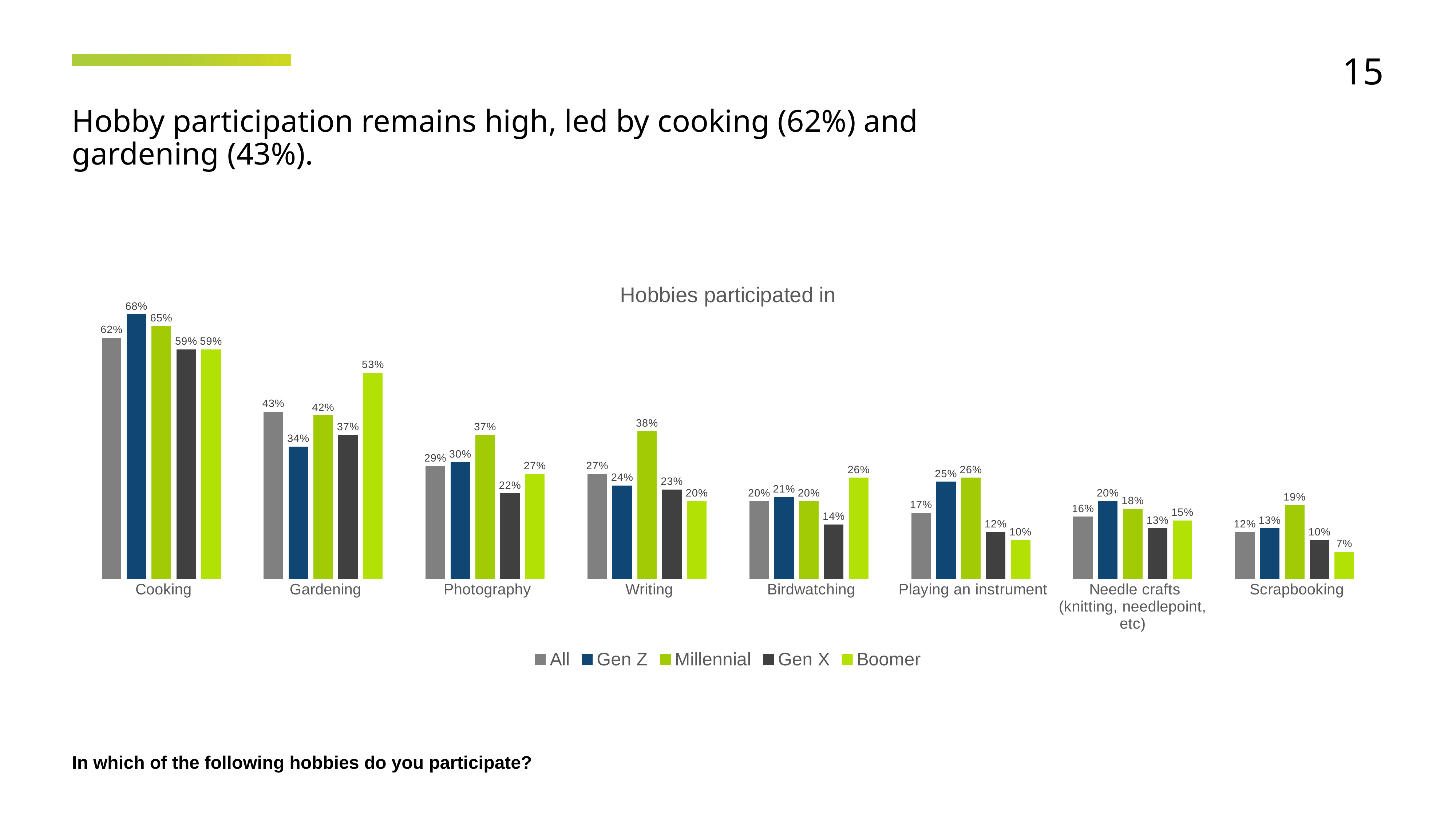
What is the title of the chart? Hobbies participated in Which is larger for Birdwatching: the Boomer value or the Gen X value? Boomer What kind of chart is shown on the slide? Bar chart What is the value for Boomer in the Gardening category? 53% Which hobby has the highest value for the All series? Cooking What is the difference between the Gen Z and Gen X values for Gardening? 3% What is the value for Gen Z in the Cooking category? 68% What is the value for Gen X in the Scrapbooking category? 10% How many series does the legend list? 5 What is the value for Millennial in the Writing category? 38% How many hobby categories are shown on the x axis? 8 Which hobby has the lowest value for the Boomer series? Scrapbooking